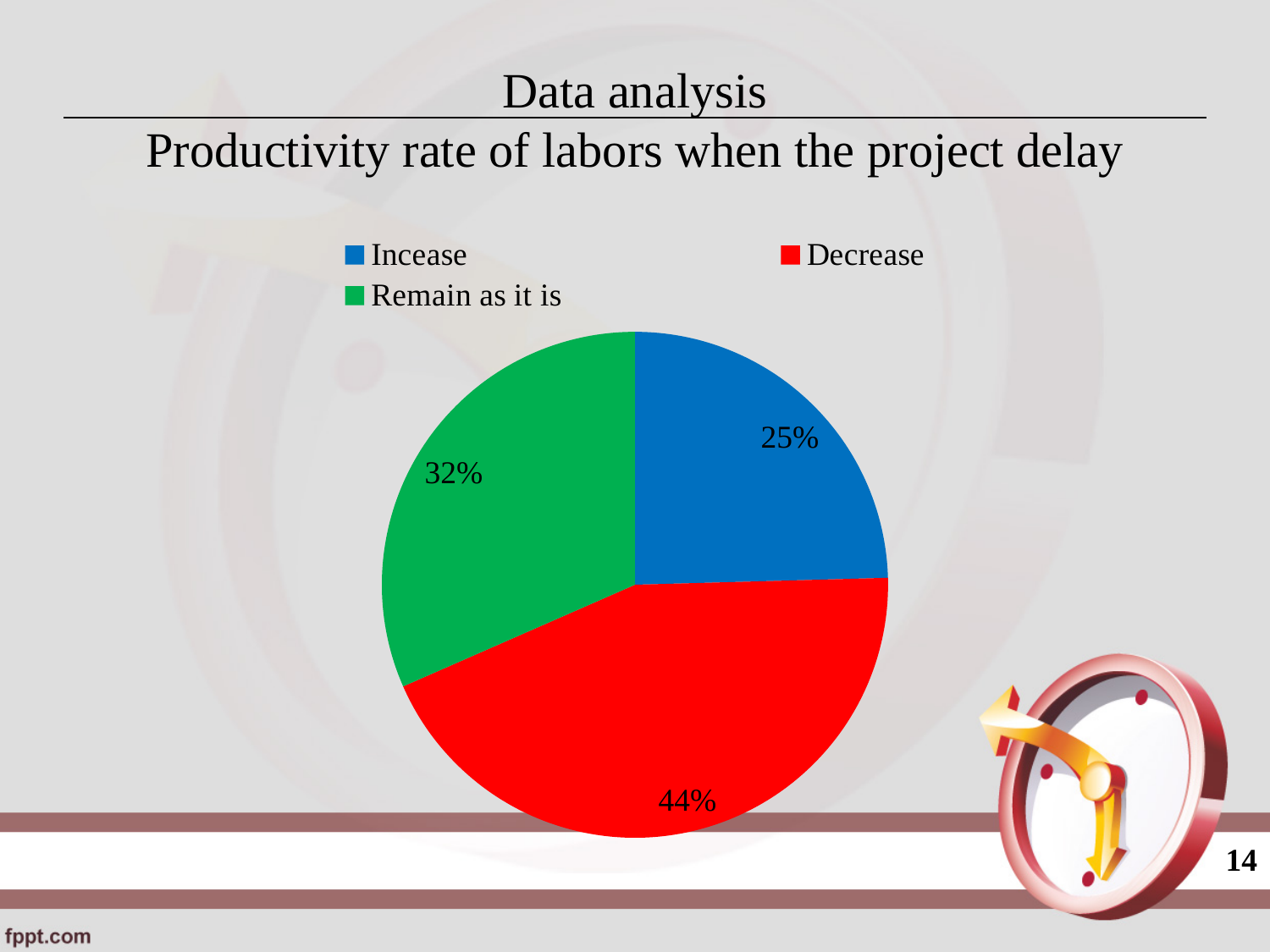
What is the difference in percentage points between the Decrease and Incease slices? 19 What percentage of the pie is labelled Incease? 25% Which category has the smallest share of the pie? Incease What kind of chart is shown on the slide? pie chart How many entries does the legend list? 3 Which is larger, the Remain as it is slice or the Decrease slice? Decrease What is the difference in percentage points between the Remain as it is and Incease slices? 7 What percentage of the pie is labelled Decrease? 44% What percentage of the pie is labelled Remain as it is? 32% How many slices does the pie chart have? 3 What colour is the Remain as it is slice? green Which category has the largest share of the pie? Decrease